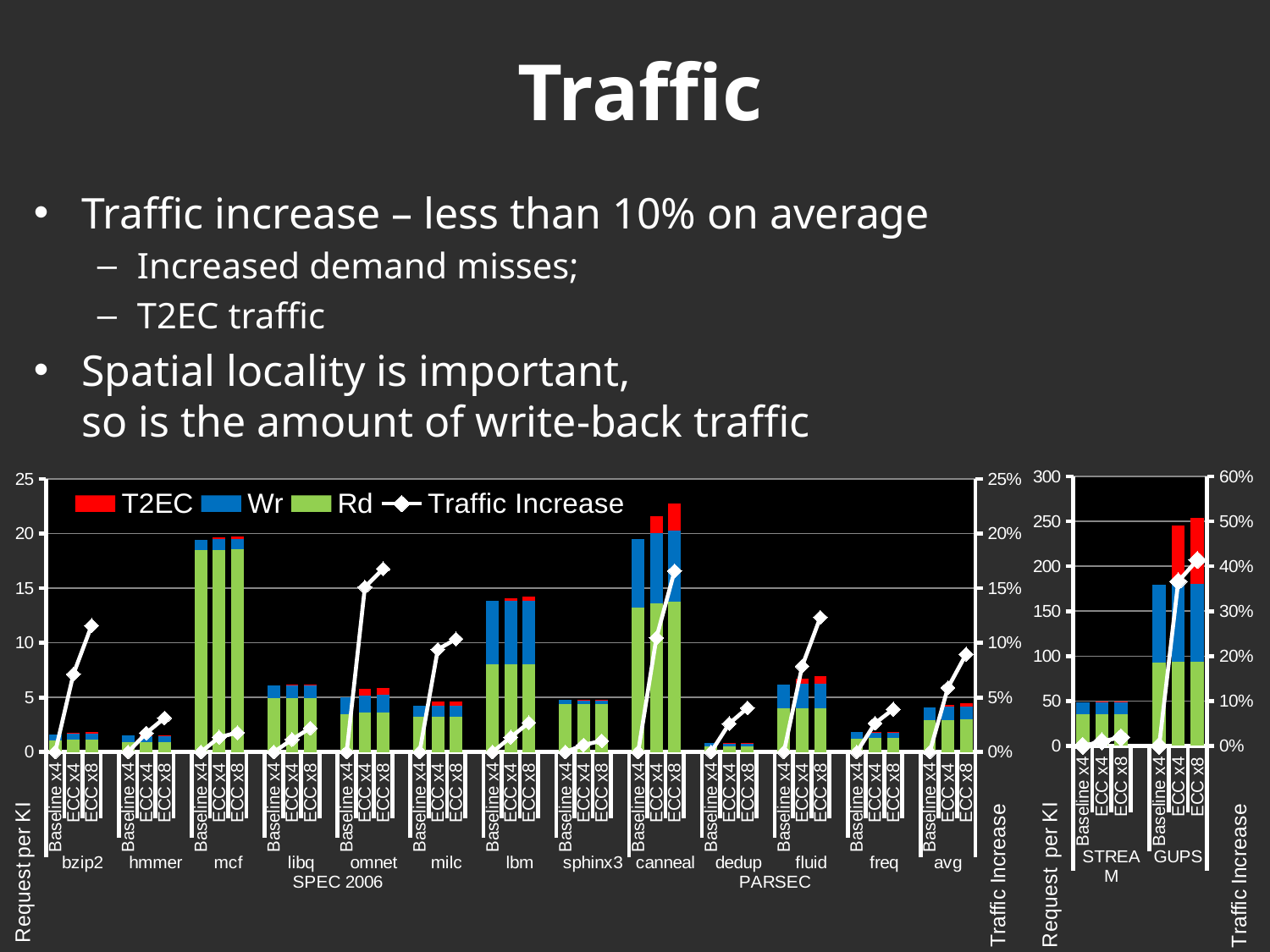
In the left chart, how many benchmark groups are shown along the x axis? 13 In the left chart, is the total Request per KI for the mcf Baseline x4 bar greater or less than 15? greater In the right chart, which benchmark has the taller stacked bars, STREAM or GUPS? GUPS In the left chart, is the Traffic Increase for avg ECC x8 greater or less than 10%? less In the left chart, how many bars are shown for each benchmark? 3 What kind of chart is the left chart? Stacked bar chart with a line In the right chart, is the total Request per KI for the GUPS ECC x8 bar greater or less than 200? greater In the left chart, which benchmark has the tallest stacked bars? canneal In the left chart, what are the legend entries? T2EC, Wr, Rd, Traffic Increase In the left chart, which benchmark has the shortest stacked bars? dedup In the left chart, how many series does the legend list? 4 In the left chart, what colour represents the Rd series? Green